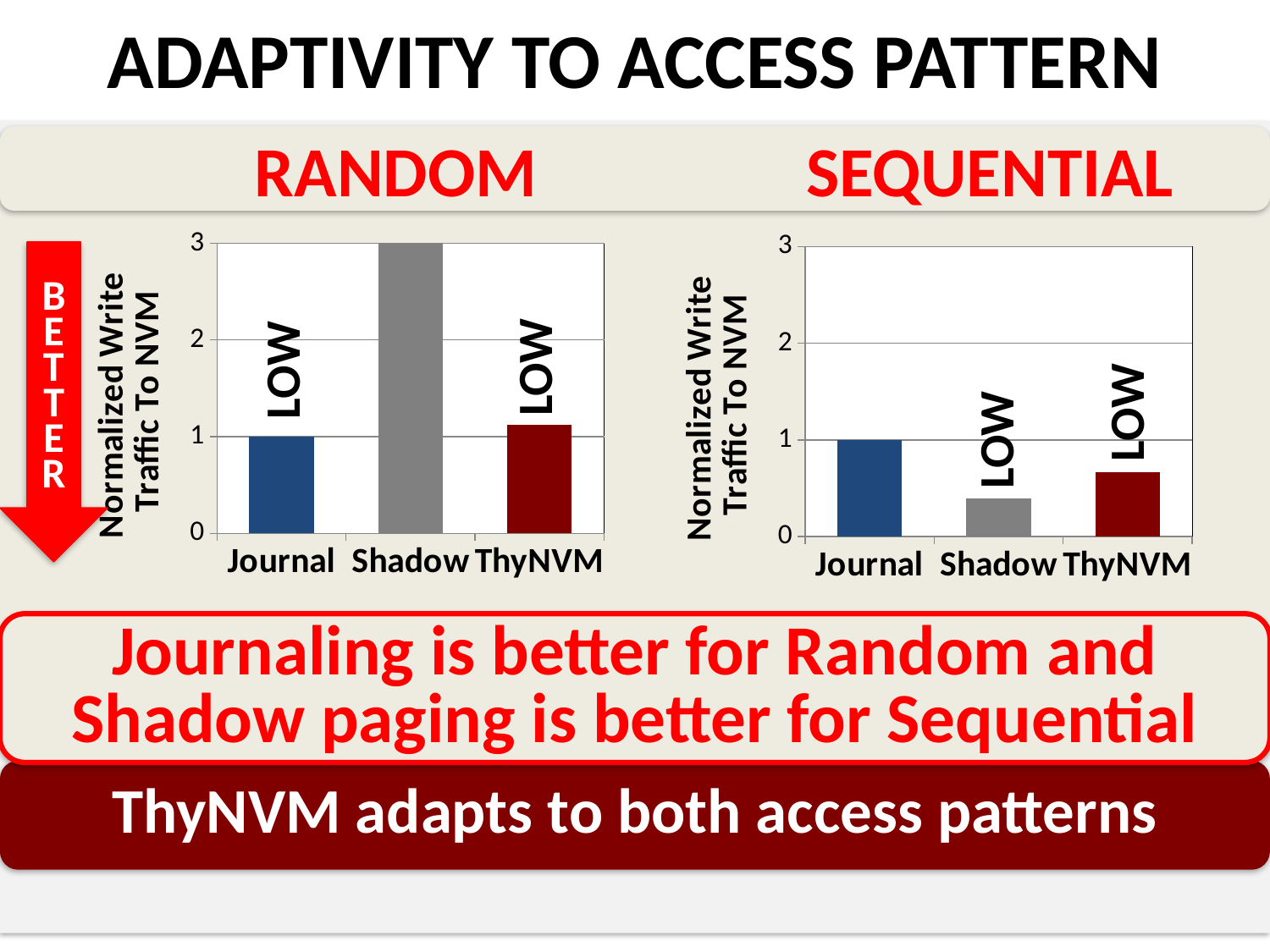
What kind of chart is the RANDOM chart? bar chart In the SEQUENTIAL chart, which category has the highest normalized write traffic? Journal What is the y-axis label of the RANDOM chart? Normalized Write Traffic To NVM In the RANDOM chart, what is the normalized write traffic for Journal? 1 In the RANDOM chart, is the value for Shadow greater or less than 2? greater In the SEQUENTIAL chart, which is larger, the value for ThyNVM or the value for Shadow? ThyNVM In the SEQUENTIAL chart, what is the normalized write traffic for Journal? 1 In the SEQUENTIAL chart, which category has the lowest normalized write traffic? Shadow In the SEQUENTIAL chart, is the value for Shadow greater or less than 1? less In the RANDOM chart, which category has the highest normalized write traffic? Shadow In the RANDOM chart, is the value for ThyNVM greater or less than 2? less How many categories are shown on the x axis of the SEQUENTIAL chart? 3